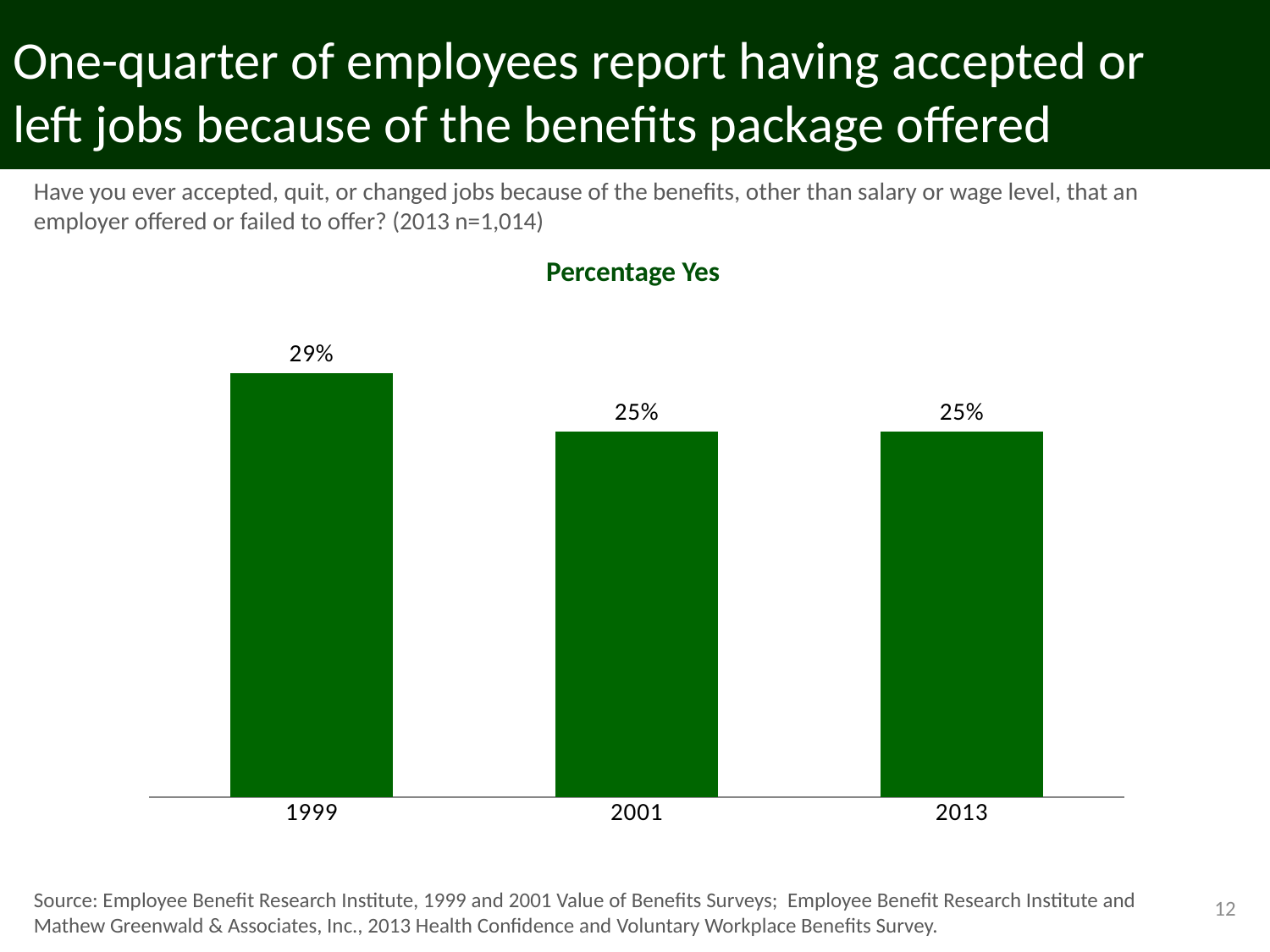
Which year has the highest percentage? 1999 What colour are the bars in the chart? Green What is the value for 2001? 25% What is the title of the chart? Percentage Yes What is the value for 1999? 29% What kind of chart is shown on the slide? Bar chart What is the difference between the values for 1999 and 2013? 4% Are the values for 2001 and 2013 the same or different? The same What is the value for 2013? 25% How many years are shown on the chart? 3 Do the values rise or fall from 1999 to 2001? Fall Which is larger, the value for 1999 or the value for 2001? 1999